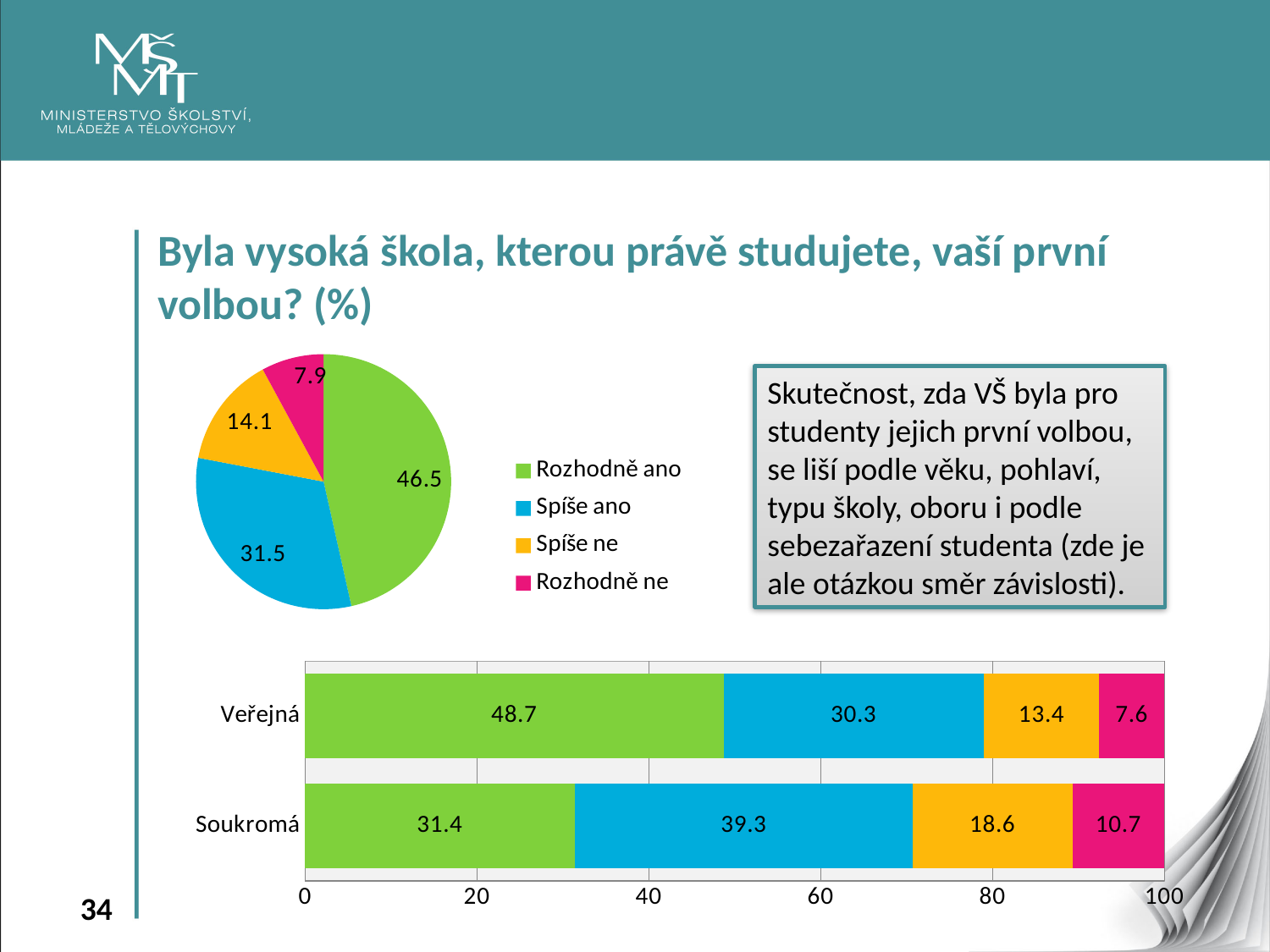
In the pie chart, what is the value for "Rozhodně ano"? 46.5 In the bottom bar chart, what is the difference between the green (Rozhodně ano) values for "Veřejná" and "Soukromá"? 17.3 In the bottom bar chart, what is the value of the green (Rozhodně ano) segment for "Veřejná"? 48.7 In the pie chart, what is the difference between the values for "Rozhodně ano" and "Spíše ano"? 15.0 How many entries does the legend of the pie chart list? 4 In the bottom bar chart, what is the value of the blue (Spíše ano) segment for "Soukromá"? 39.3 In the bottom bar chart, which has the larger green (Rozhodně ano) segment, "Veřejná" or "Soukromá"? Veřejná What kind of chart is the bottom chart on the slide? Stacked bar chart In the pie chart, what is the value for "Spíše ne"? 14.1 In the pie chart, which category has the largest slice? Rozhodně ano In the pie chart, which category has the smallest slice? Rozhodně ne How many categories are shown on the vertical axis of the bottom bar chart? 2